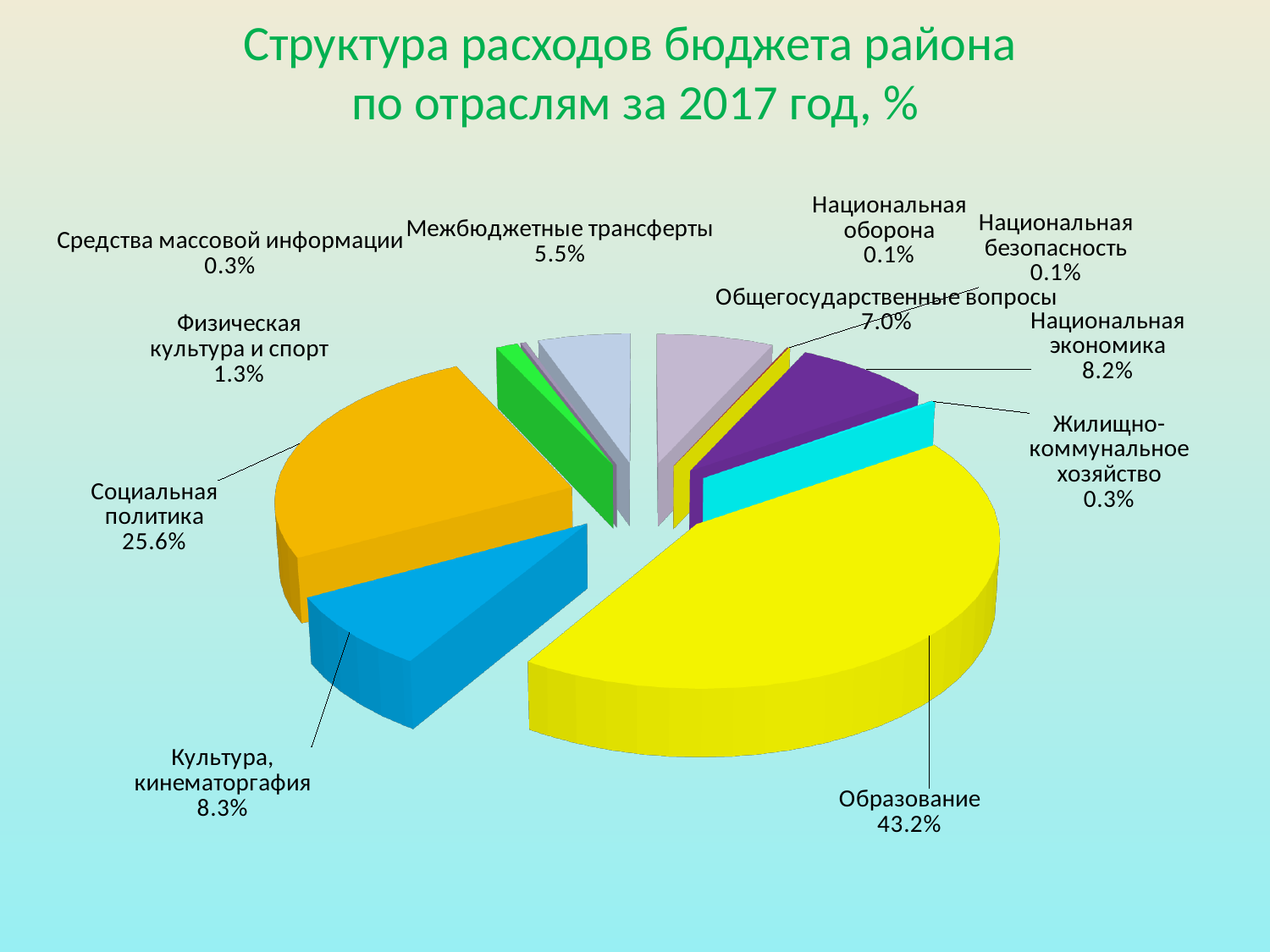
What kind of chart is shown on the slide? pie chart What is the value for Национальная экономика? 8.2% What share of the budget expenditure goes to Образование? 43.2% What is the difference between the shares of Культура, кинематоргафия and Физическая культура и спорт? 7.0% Which category has the largest share of the budget expenditure? Образование What is the value for Социальная политика? 25.6% What is the value for Межбюджетные трансферты? 5.5% Which is larger, the share for Общегосударственные вопросы or the share for Межбюджетные трансферты? Общегосударственные вопросы What is the value for Физическая культура и спорт? 1.3% What is the difference between the shares of Образование and Социальная политика? 17.6% How many categories are shown in the pie chart? 11 What is the title of the chart? Структура расходов бюджета района по отраслям за 2017 год, %